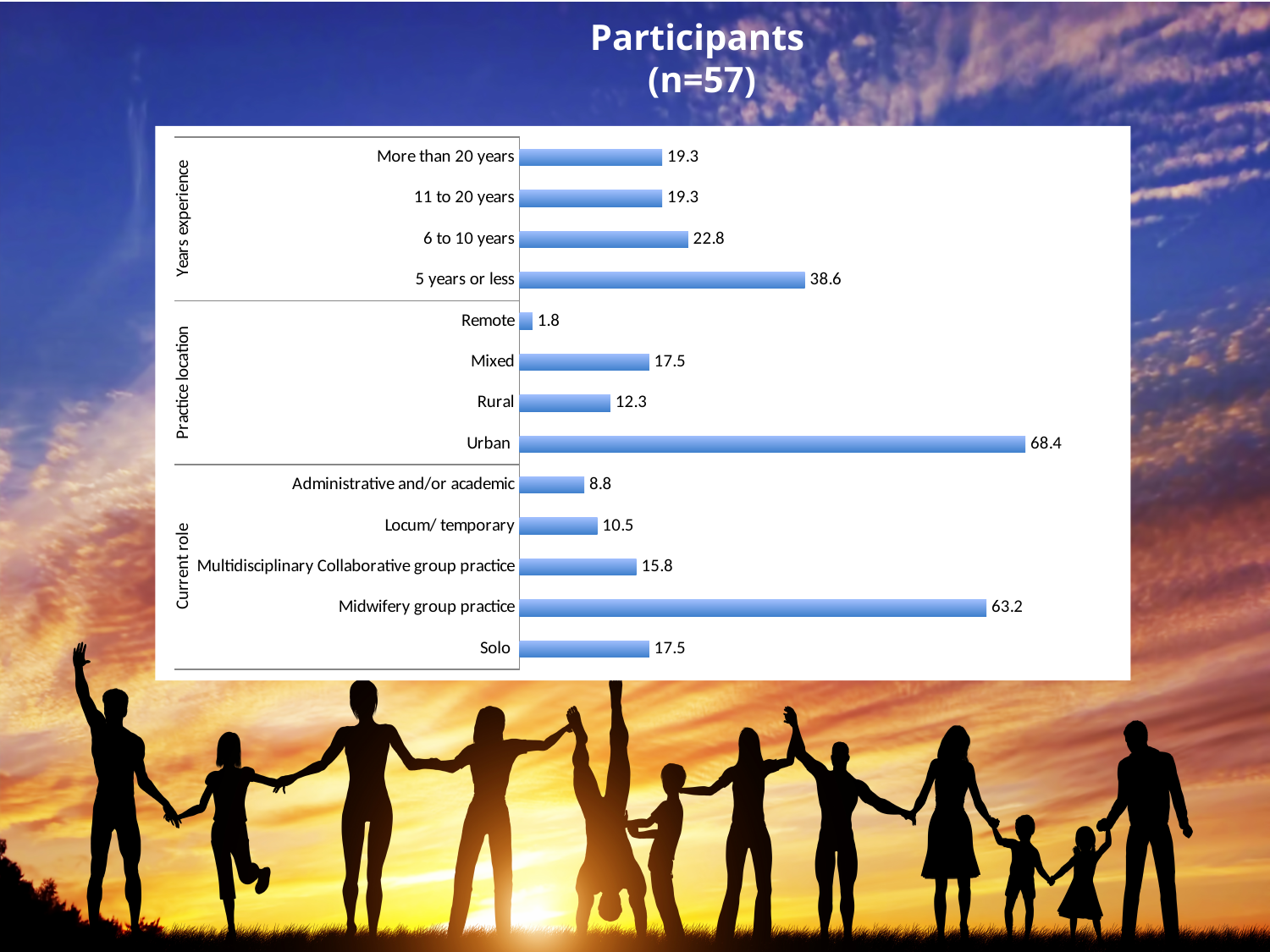
What is the value for Remote? 1.8 Which Current role category has the lowest value? Administrative and/or academic Which category has the highest value on the chart? Urban What is the difference between the values for Urban and Rural? 56.1 What is the difference between the values for 5 years or less and 6 to 10 years? 15.8 Which category has the lowest value on the chart? Remote What is the value for Urban in the Practice location group? 68.4 What is the value for 5 years or less in the Years experience group? 38.6 How many categories are plotted on the chart in total? 13 What is the value for Midwifery group practice in the Current role group? 63.2 Which is larger, the value for Mixed or the value for Rural? Mixed What kind of chart is shown on the slide? Bar chart